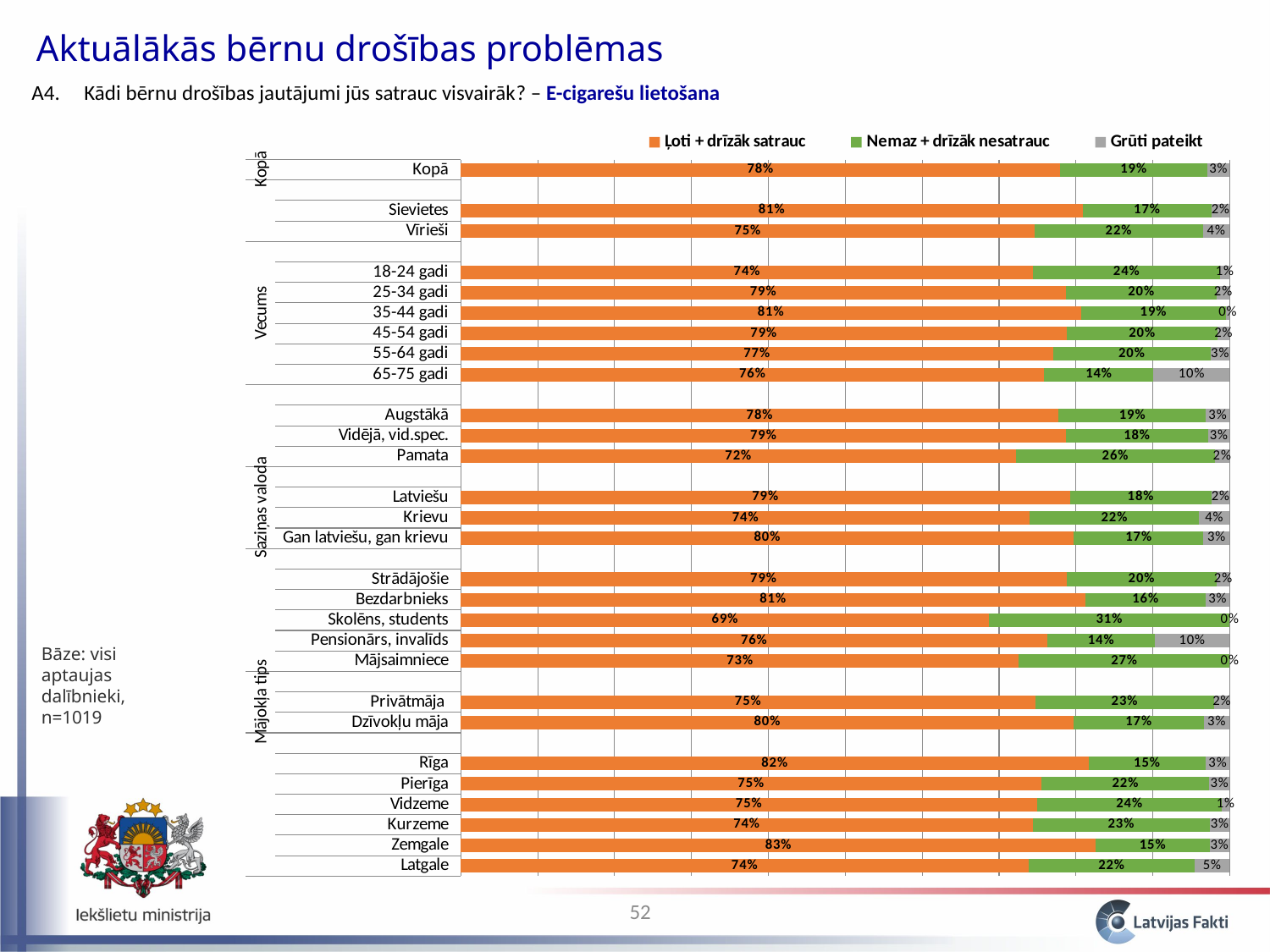
Which category has the highest value for "Ļoti + drīzāk satrauc"? Zemgale Which category has the lowest value for "Ļoti + drīzāk satrauc"? Skolēns, students What is the value of "Grūti pateikt" for 65-75 gadi? 10% Which has a larger "Nemaz + drīzāk nesatrauc" value, Pamata or Augstākā? Pamata What is the difference between the "Ļoti + drīzāk satrauc" values for Sievietes and Vīrieši? 6% What is the value of "Nemaz + drīzāk nesatrauc" for Skolēns, students? 31% Which series is shown in orange in the legend? Ļoti + drīzāk satrauc What is the value of "Ļoti + drīzāk satrauc" for Rīga? 82% What is the value of "Ļoti + drīzāk satrauc" for Kopā? 78% How many series does the legend list? 3 What type of chart is shown on the slide? Stacked bar chart What is the difference between the "Nemaz + drīzāk nesatrauc" values for Latgale and Zemgale? 7%